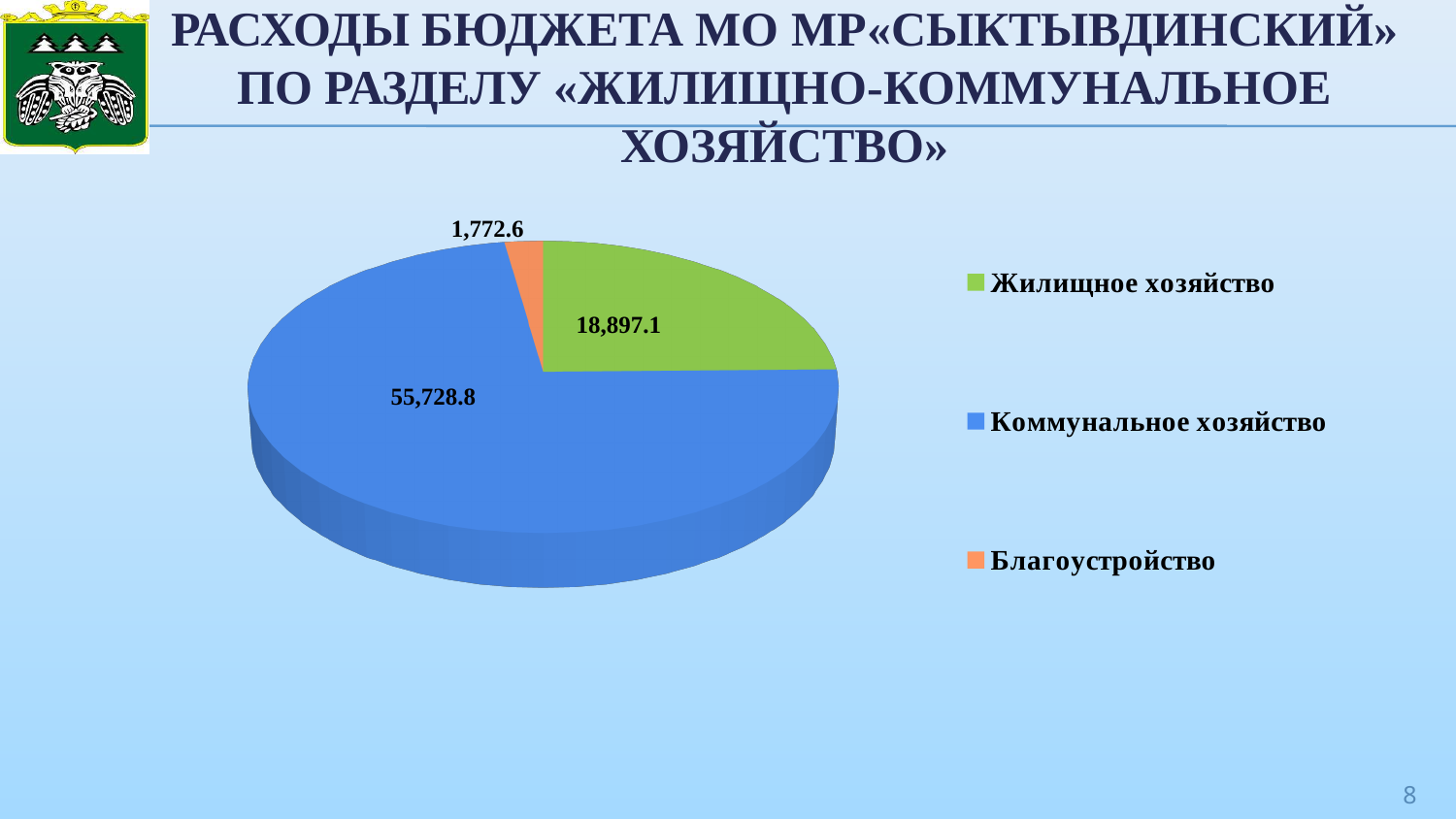
How many categories does the pie chart have? 3 What is the value for Жилищное хозяйство? 18,897.1 What type of chart is shown on the slide? Pie chart Which is larger, the value for Жилищное хозяйство or the value for Благоустройство? Жилищное хозяйство Which category has the largest slice of the pie? Коммунальное хозяйство What is the difference between the values for Жилищное хозяйство and Благоустройство? 17,124.5 What is the value for Коммунальное хозяйство? 55,728.8 What is the difference between the values for Коммунальное хозяйство and Жилищное хозяйство? 36,831.7 Which category has the smallest slice of the pie? Благоустройство What colour is the slice for Благоустройство? Orange What is the total of all slices in the pie chart? 76,398.5 What is the value for Благоустройство? 1,772.6